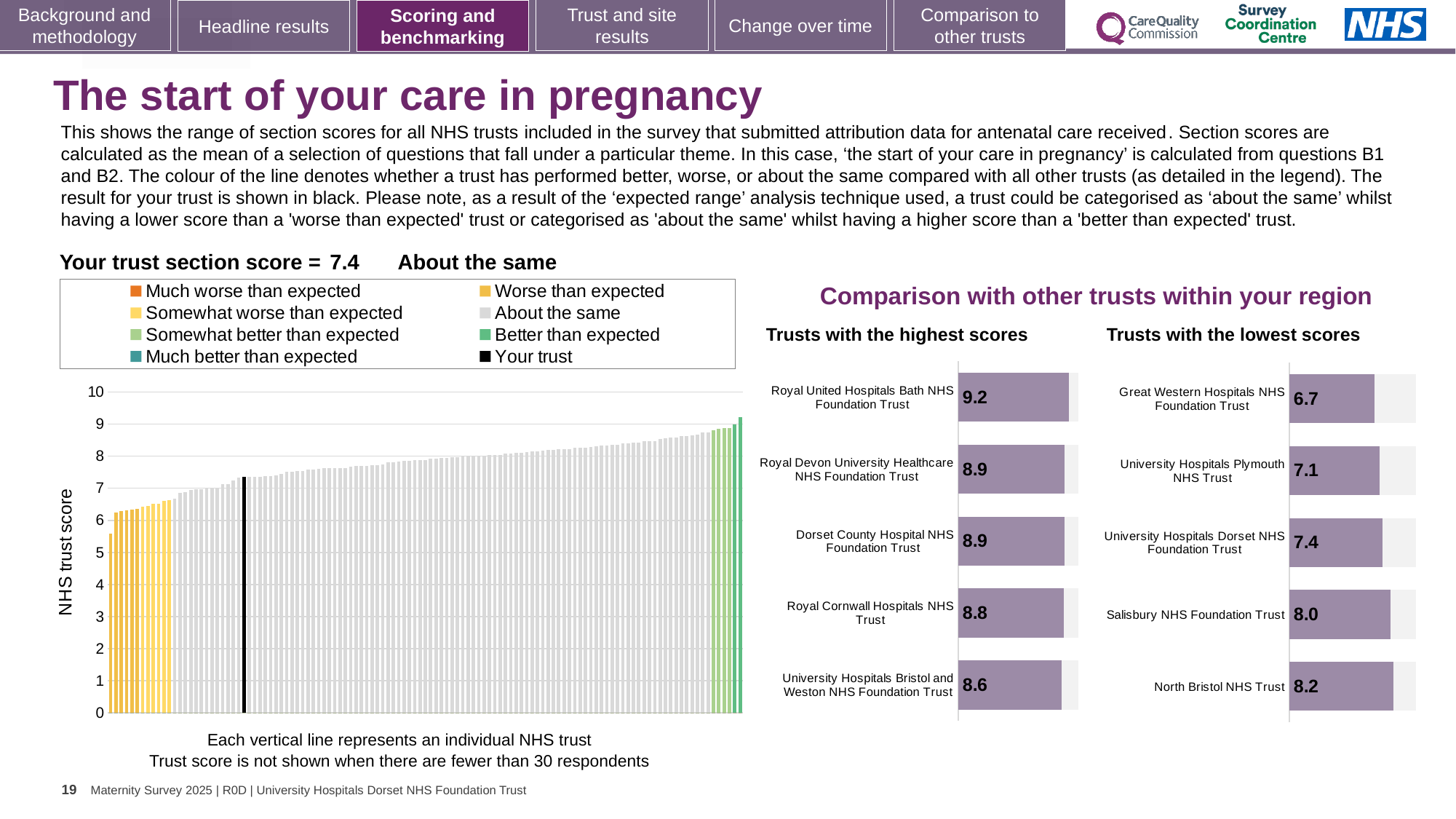
What kind of chart is the 'Trusts with the lowest scores' chart? bar chart In the 'Trusts with the lowest scores' chart, which trust has the lowest score? Great Western Hospitals NHS Foundation Trust In the 'Trusts with the lowest scores' chart, which has the larger score: University Hospitals Plymouth NHS Trust or North Bristol NHS Trust? North Bristol NHS Trust In the main 'NHS trust score' chart on the left, do the trust scores rise or fall from left to right? rise How many trusts are shown in the 'Trusts with the highest scores' chart? 5 In the 'Trusts with the lowest scores' chart, what is the score for Salisbury NHS Foundation Trust? 8.0 How many entries does the legend above the main 'NHS trust score' chart list? 8 In the 'Trusts with the lowest scores' chart, what is the score for Great Western Hospitals NHS Foundation Trust? 6.7 In the 'Trusts with the highest scores' chart, what is the score for Royal United Hospitals Bath NHS Foundation Trust? 9.2 In the 'Trusts with the highest scores' chart, what is the difference between the scores of Royal United Hospitals Bath NHS Foundation Trust and University Hospitals Bristol and Weston NHS Foundation Trust? 0.6 In the main 'NHS trust score' chart on the left, what is the section score for your trust (the black bar)? 7.4 In the 'Trusts with the highest scores' chart, which trust has the highest score? Royal United Hospitals Bath NHS Foundation Trust